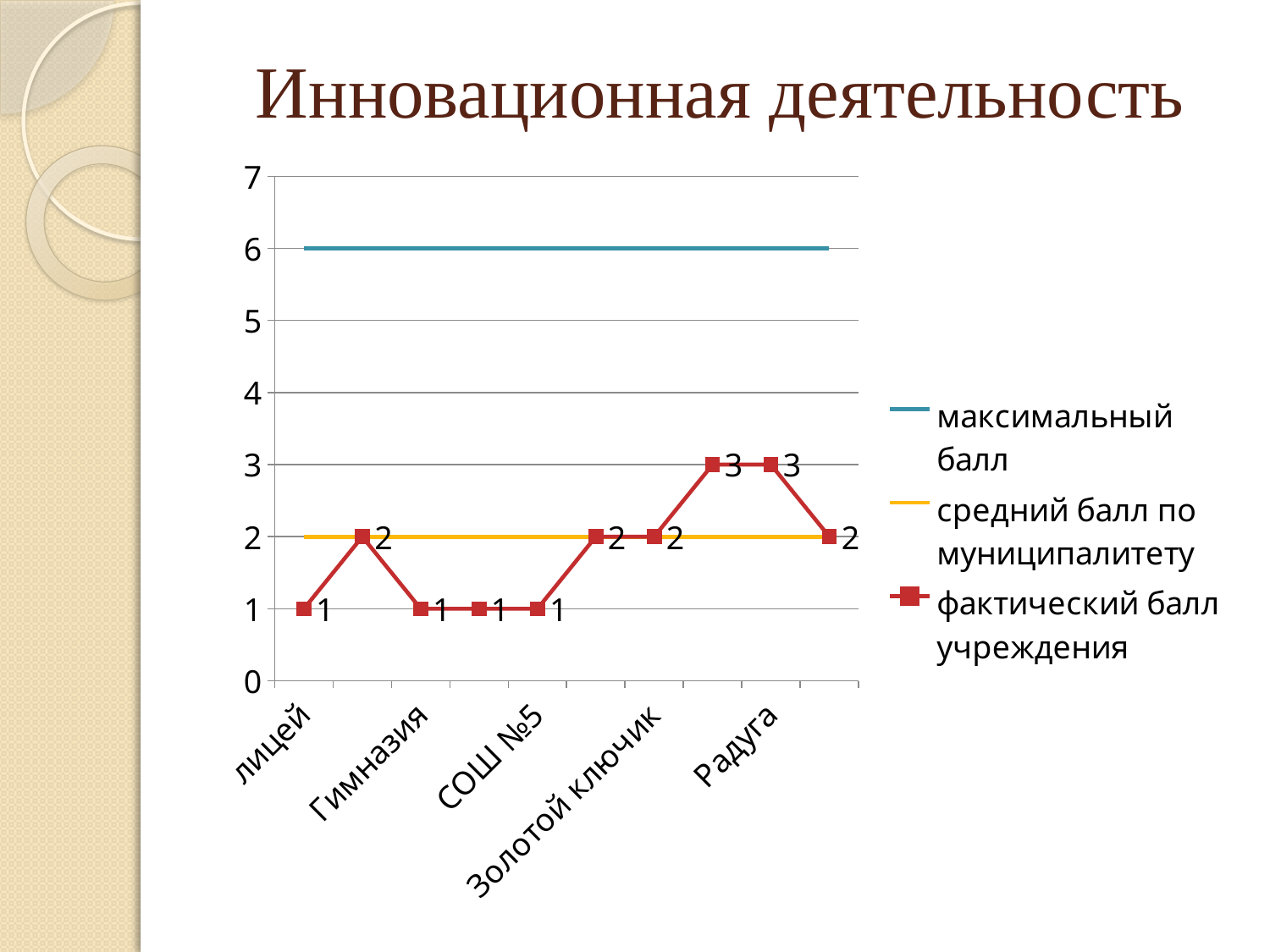
Which has a higher фактический балл учреждения, Радуга or Гимназия? Радуга What is the фактический балл учреждения for СОШ №5? 1 What value does the максимальный балл line sit at? 6 What is the фактический балл учреждения for Радуга? 3 What value does the средний балл по муниципалитету line sit at? 2 What kind of chart is shown on the slide? line chart What is the difference between the фактический балл for Радуга and for лицей? 2 What is the фактический балл учреждения for Золотой ключик? 2 Is the максимальный балл line greater or less than 5? greater What is the фактический балл учреждения for лицей? 1 How many series does the legend list? 3 What is the title of the slide? Инновационная деятельность